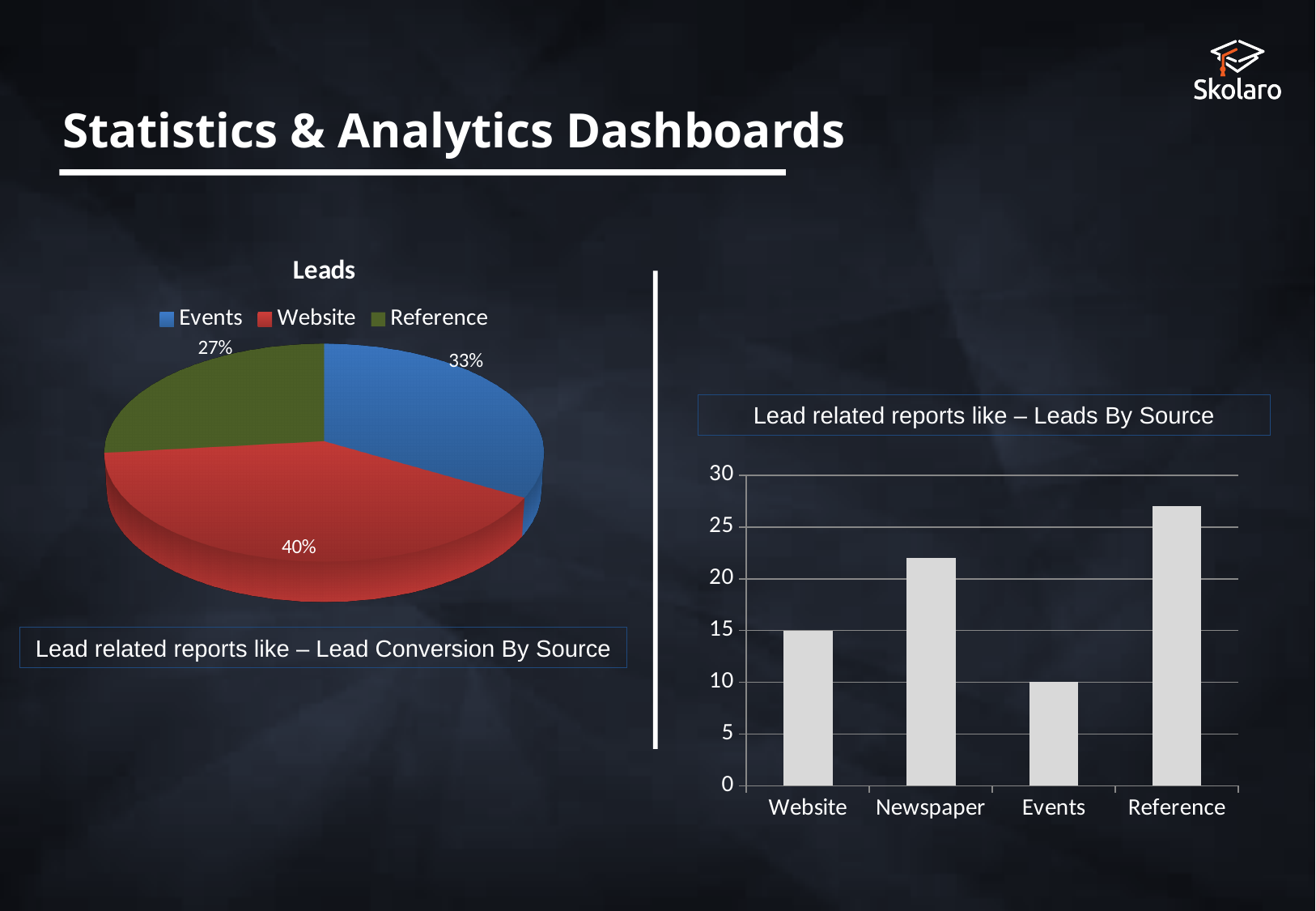
In the bar chart on the right of the slide, what is the value for Website? 15 In the pie chart titled Leads, what share does Reference have? 27% In the pie chart titled Leads, which category has the smallest slice? Reference In the pie chart titled Leads, how many percentage points larger is Website's share than Events' share? 7 In the pie chart titled Leads, which colour represents Events? Blue In the bar chart on the right of the slide, what is the value for Events? 10 In the pie chart titled Leads, what share does Website have? 40% In the bar chart on the right of the slide, which category has the highest bar? Reference In the pie chart titled Leads, which category has the largest slice? Website In the bar chart on the right of the slide, is the value for Reference greater or less than 25? greater In the pie chart titled Leads, how many entries does the legend list? 3 In the bar chart on the right of the slide, how many categories are shown on the x axis? 4